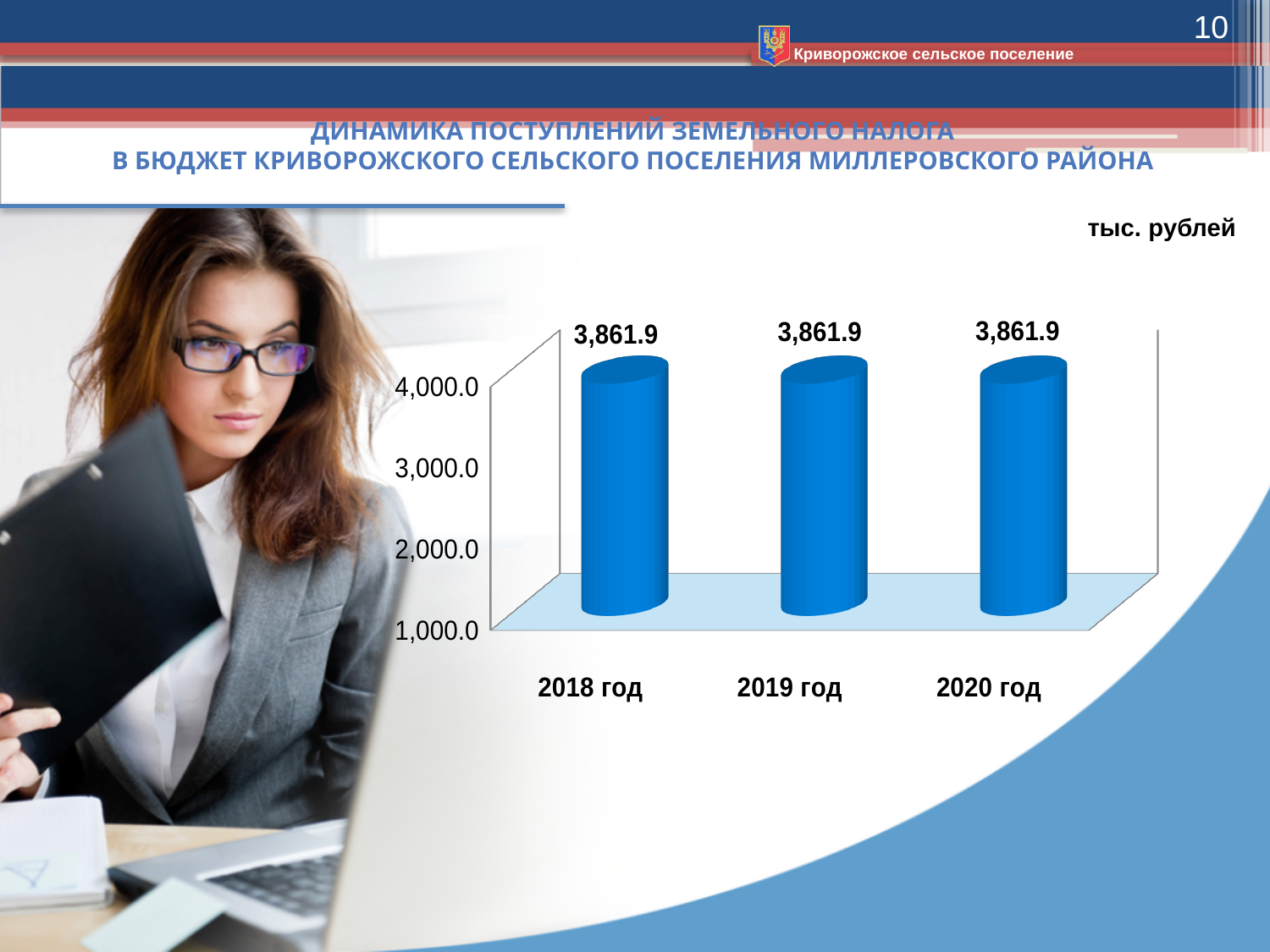
What is the value for 2020 год? 3,861.9 What kind of chart is shown on the slide? bar chart Do the values rise, fall, or stay the same from 2018 год to 2020 год? stay the same In what units are the chart values expressed? тыс. рублей What is the value for 2018 год? 3,861.9 What is the lowest value shown on the vertical axis? 1,000.0 How many categories (years) are shown on the chart? 3 What is the difference between the values for 2020 год and 2018 год? 0.0 What is the value for 2019 год? 3,861.9 Is the value for 2019 год larger than, smaller than, or equal to the value for 2018 год? equal Is the value for 2020 год greater or less than 3,000.0? greater Is the value for 2018 год greater or less than 4,000.0? less